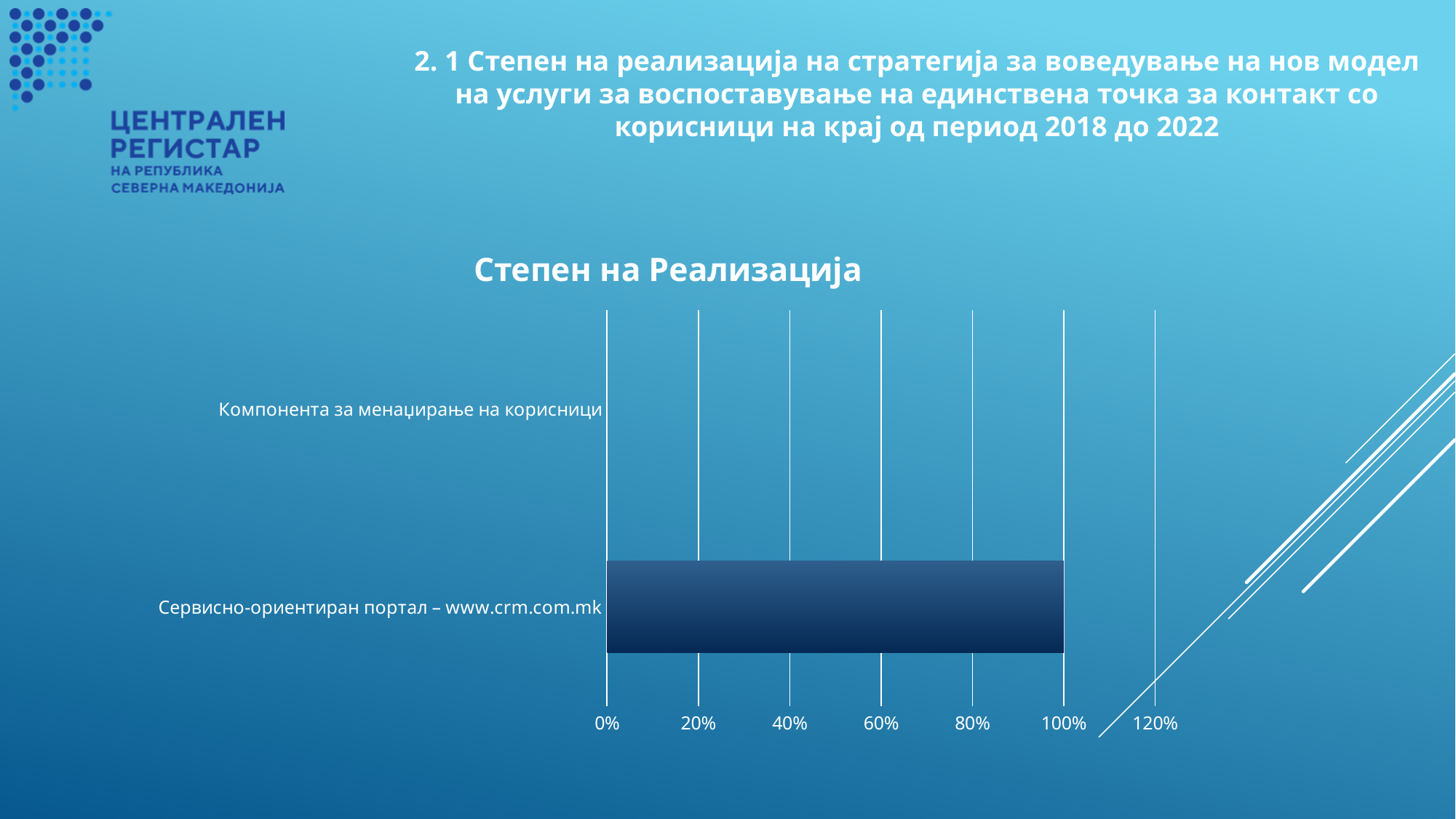
What kind of chart is shown on the slide? bar chart What is the title of the chart? Степен на Реализација Is the value for Сервисно-ориентиран портал – www.crm.com.mk greater or less than 120%? less Which has the larger value: Сервисно-ориентиран портал – www.crm.com.mk or Компонента за менаџирање на корисници? Сервисно-ориентиран портал – www.crm.com.mk How many categories are shown on the chart's vertical axis? 2 What is the highest value labelled on the chart's horizontal axis? 120% Which category has the highest value on the chart? Сервисно-ориентиран портал – www.crm.com.mk Is the value for Сервисно-ориентиран портал – www.crm.com.mk greater or less than 80%? greater What is the value for Сервисно-ориентиран портал – www.crm.com.mk? 100%